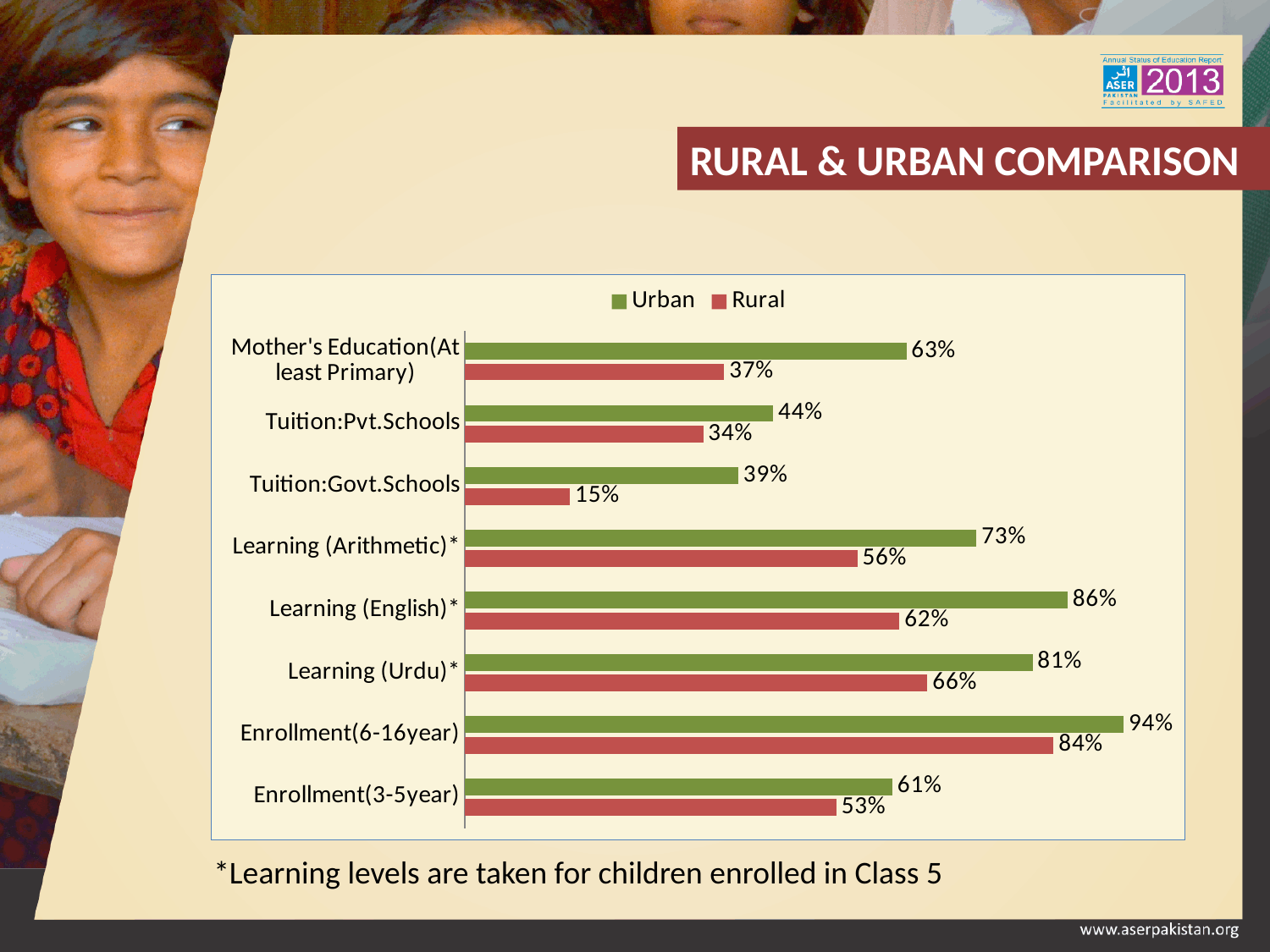
How many series does the legend list? 2 What is the difference between the Urban and Rural values for Enrollment(6-16year)? 10% Which is larger: the Rural value for Learning (Urdu)* or the Rural value for Learning (Arithmetic)*? Learning (Urdu)* Which series is shown in green in the legend? Urban Which category has the highest Urban value? Enrollment(6-16year) What is the difference between the Urban and Rural values for Mother's Education (At least Primary)? 26% How many categories are shown on the chart? 8 What kind of chart is shown on the slide? Bar chart What is the Rural value for Learning (English)*? 62% What is the Rural value for Tuition:Govt.Schools? 15% What is the Urban value for Mother's Education (At least Primary)? 63% Which category has the lowest Rural value? Tuition:Govt.Schools